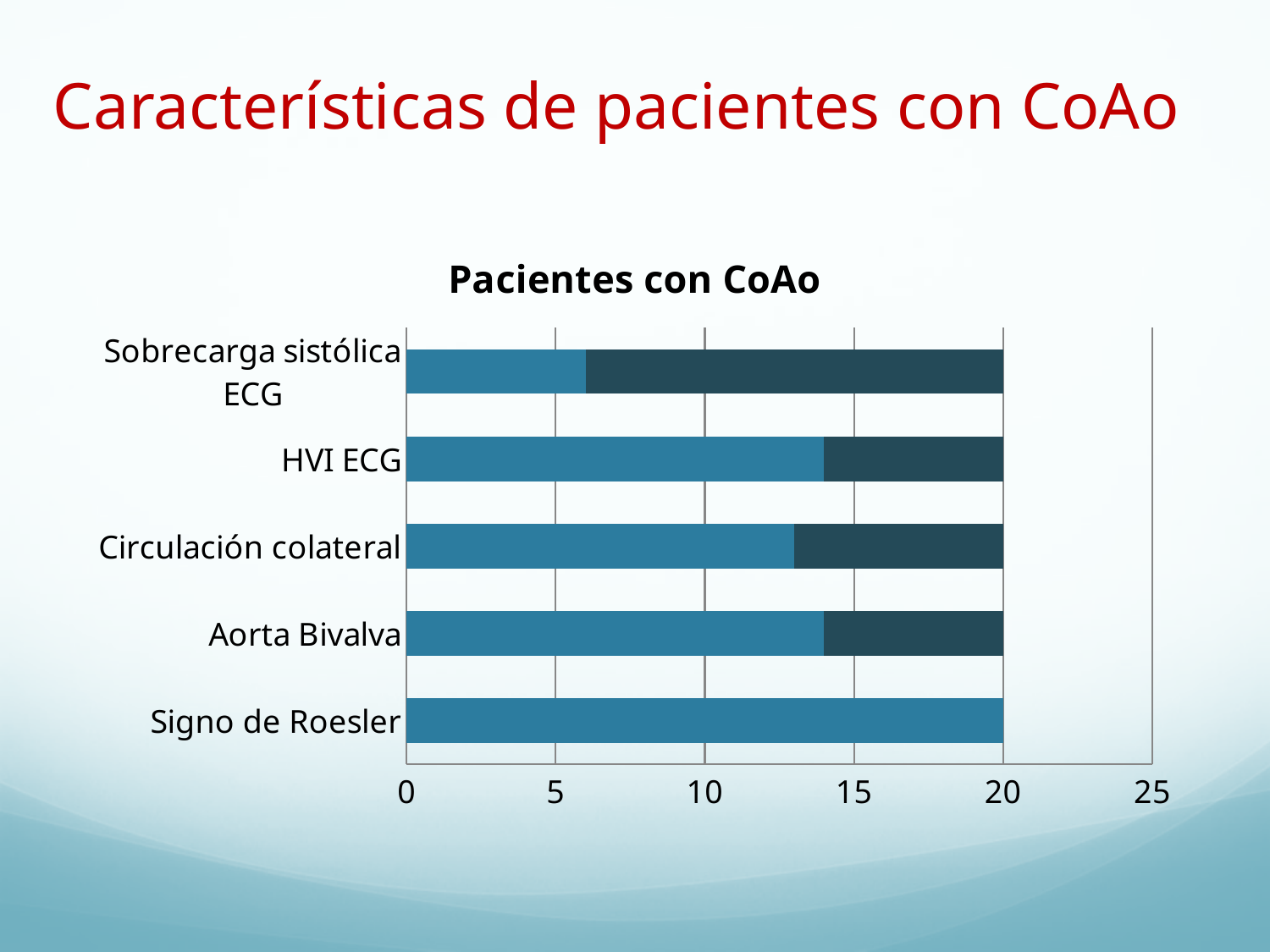
Which category has the shortest light blue segment? Sobrecarga sistólica ECG Which has the larger light blue segment, Sobrecarga sistólica ECG or HVI ECG? HVI ECG Is the light blue segment for Aorta Bivalva greater or less than 15? less Which category has the longest light blue segment? Signo de Roesler What kind of chart is shown on the slide? bar chart What is the total length of the stacked bar for HVI ECG? 20 Is the light blue segment for Sobrecarga sistólica ECG greater or less than 10? less What is the title of the chart? Pacientes con CoAo How many categories are plotted in the chart? 5 What is the total length of the stacked bar for Sobrecarga sistólica ECG? 20 Is the light blue segment for HVI ECG greater or less than 10? greater What value does the bar for Signo de Roesler reach? 20